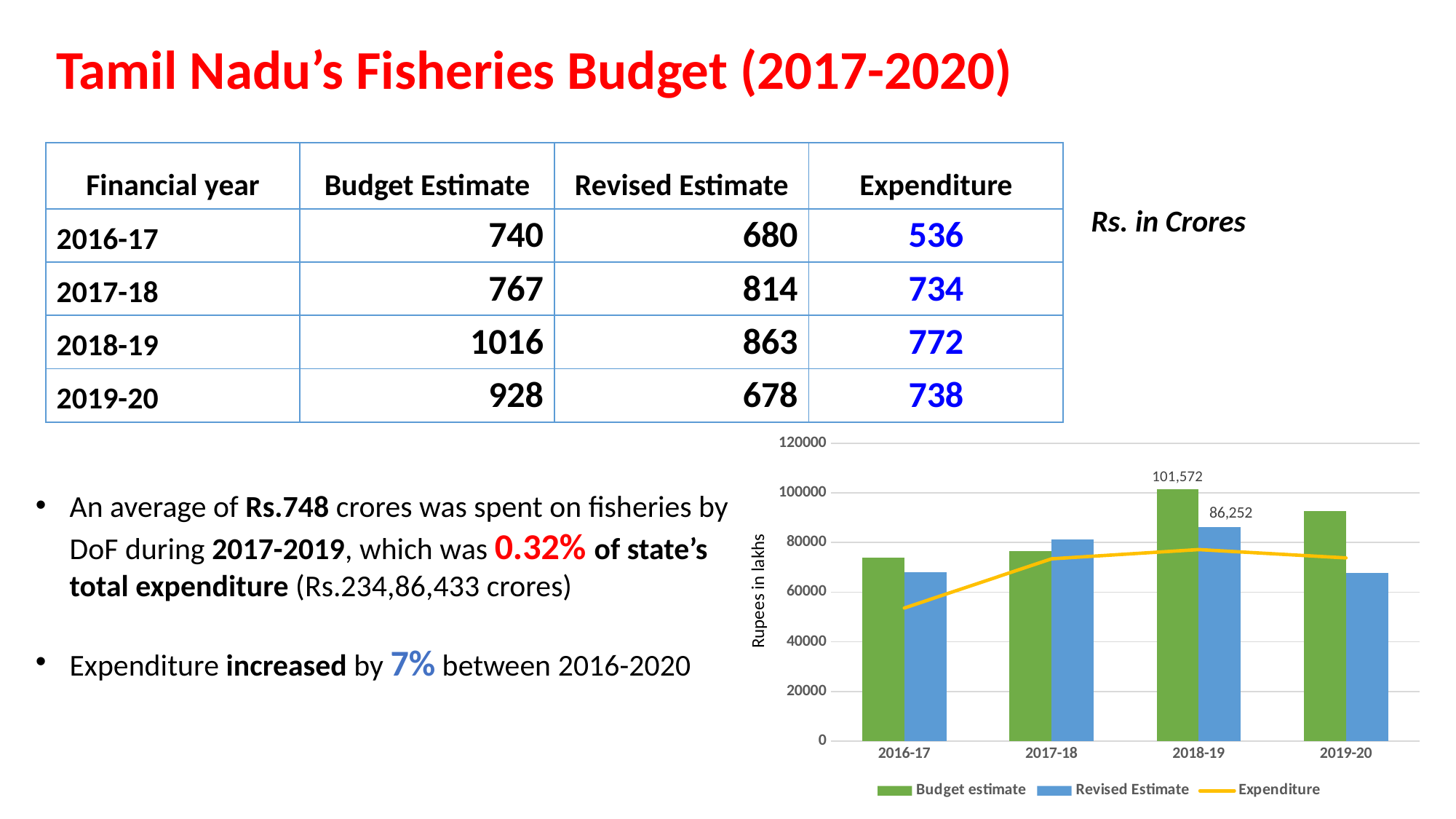
What is the Budget estimate value for 2018-19 shown on the chart? 101,572 What is the label on the vertical axis of the chart? Rupees in lakhs On the chart, is the Expenditure line value for 2016-17 greater or less than 60000? less Which financial year has the highest Budget estimate bar on the chart? 2018-19 What is the difference between the Budget estimate and the Revised Estimate for 2018-19 on the chart? 15,320 In 2017-18, which is larger on the chart: the Budget estimate or the Revised Estimate? Revised Estimate How many series does the chart legend list? 3 How many financial years are shown on the x axis of the chart? 4 On the chart, is the Budget estimate for 2019-20 greater or less than 80000? greater On the chart, is the Revised Estimate for 2016-17 greater or less than 80000? less What is the Revised Estimate value for 2018-19 shown on the chart? 86,252 Which financial year has the highest Revised Estimate bar on the chart? 2018-19